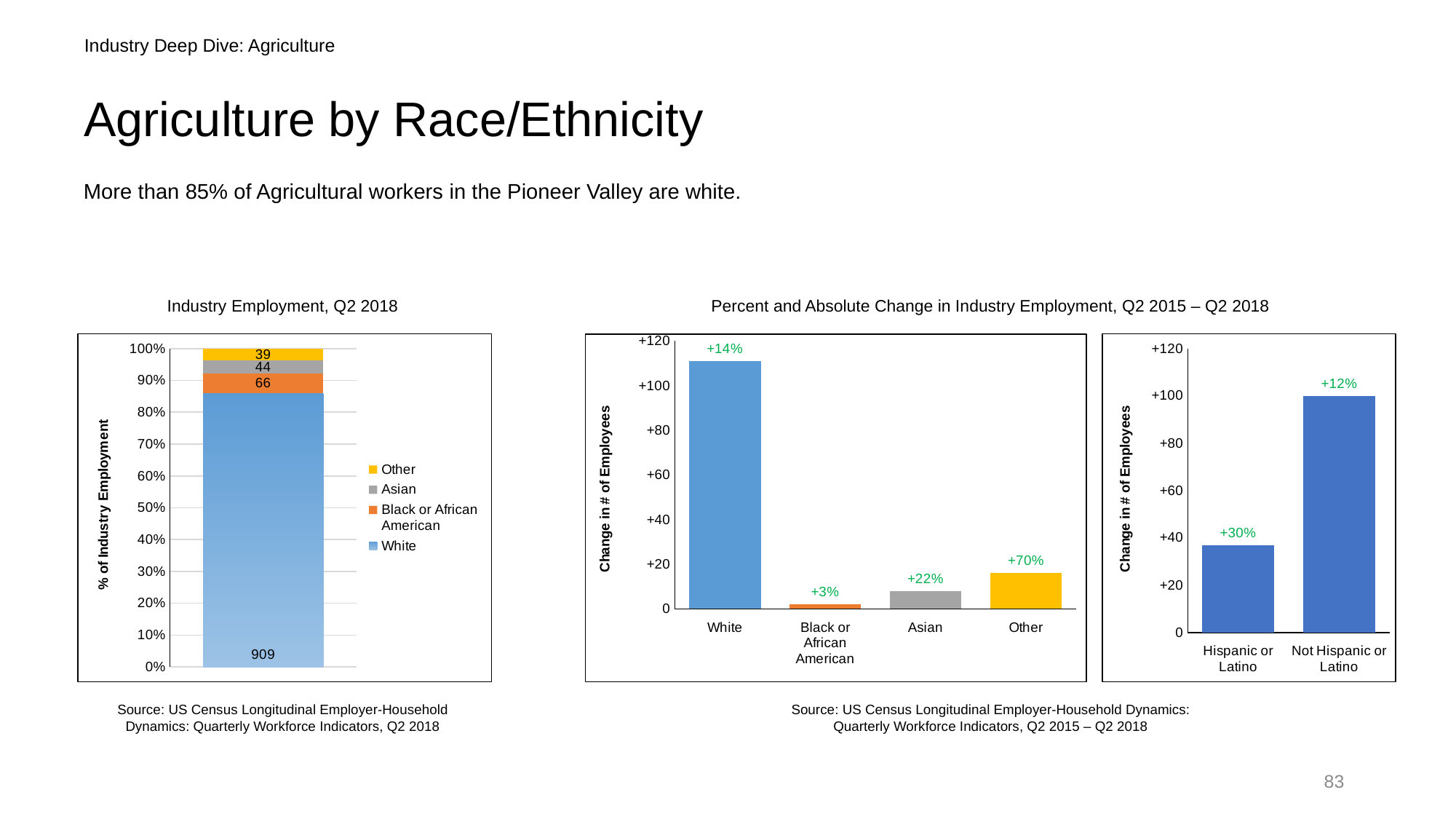
In the Industry Employment, Q2 2018 chart, what is the difference between the Black or African American value and the Asian value? 22 In the Industry Employment, Q2 2018 chart, what is the value labelled on the Asian segment? 44 In the middle chart (Percent and Absolute Change in Industry Employment by race), which category has the largest change in number of employees? White In the middle chart (Percent and Absolute Change in Industry Employment by race), what percent change is labelled for Black or African American? +3% In the Industry Employment, Q2 2018 chart, what is the total of all four labelled segments in the stacked bar? 1058 In the middle chart (Percent and Absolute Change in Industry Employment by race), is the change in number of employees for White greater or less than +100? greater In the middle chart (Percent and Absolute Change in Industry Employment by race), what percent change is labelled for Other? +70% In the rightmost chart (change in employment by Hispanic or Latino status), which category has the larger change in number of employees, Hispanic or Latino or Not Hispanic or Latino? Not Hispanic or Latino In the Industry Employment, Q2 2018 chart, how many series does the legend list? 4 In the rightmost chart (change in employment by Hispanic or Latino status), what percent change is labelled for Hispanic or Latino? +30% In the middle chart (Percent and Absolute Change in Industry Employment by race), how many categories are shown on the x axis? 4 In the Industry Employment, Q2 2018 chart, what is the value labelled on the White segment? 909